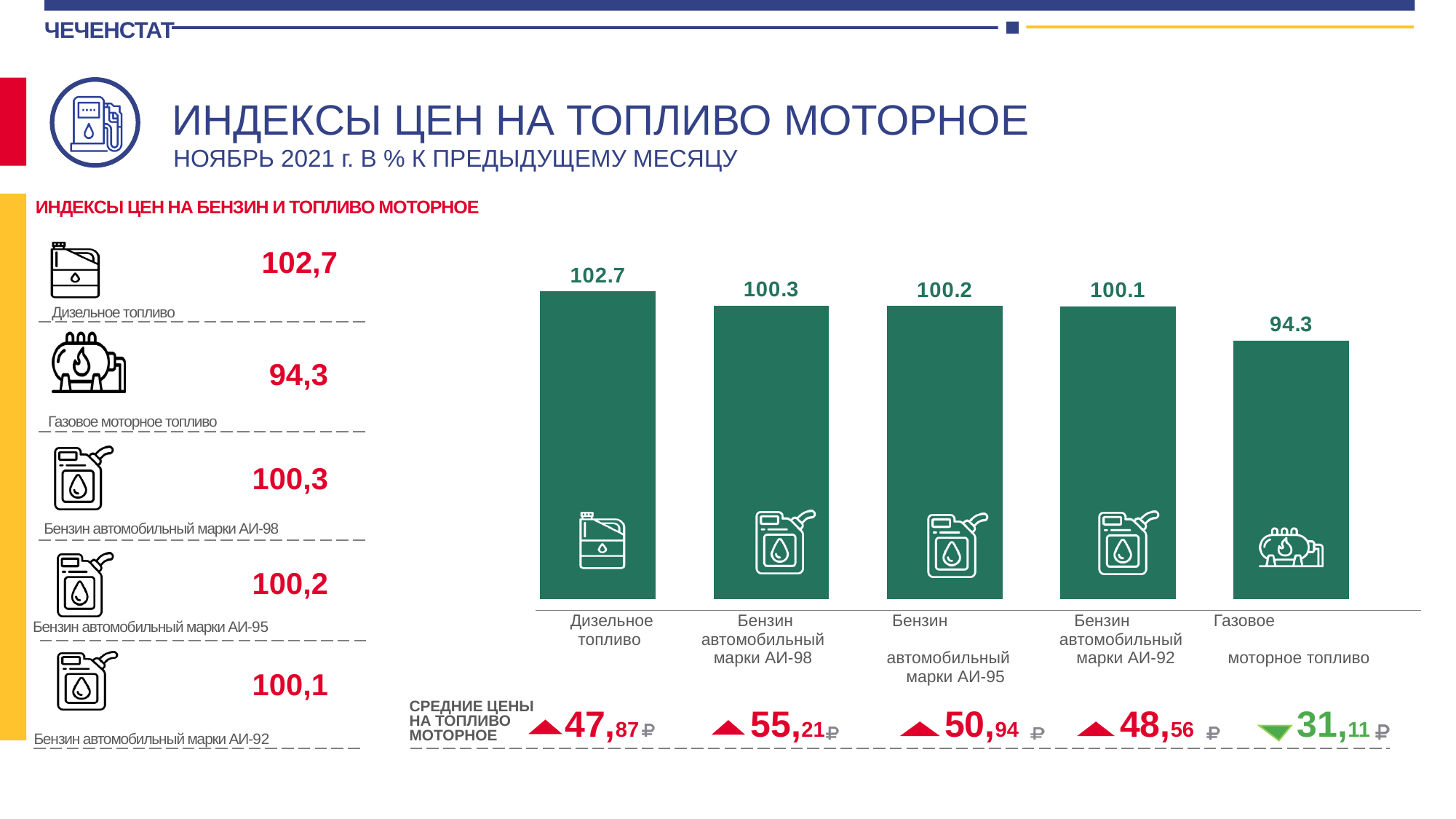
What is the value for Бензин автомобильный марки АИ-95 in the bar chart? 100.2 Which is larger: the value for Дизельное топливо or the value for Бензин автомобильный марки АИ-98? Дизельное топливо Which category has the highest value in the bar chart? Дизельное топливо What kind of chart is shown on the slide? bar chart What is the difference between the values for Бензин автомобильный марки АИ-98 and Бензин автомобильный марки АИ-92? 0.2 What colour are the bars in the chart? green What is the value for Газовое моторное топливо in the bar chart? 94.3 What is the value for Дизельное топливо in the bar chart? 102.7 Which category has the lowest value in the bar chart? Газовое моторное топливо How many bars are in the bar chart? 5 What is the difference between the values for Дизельное топливо and Газовое моторное топливо? 8.4 Do the values rise or fall from left to right across the bar chart? fall